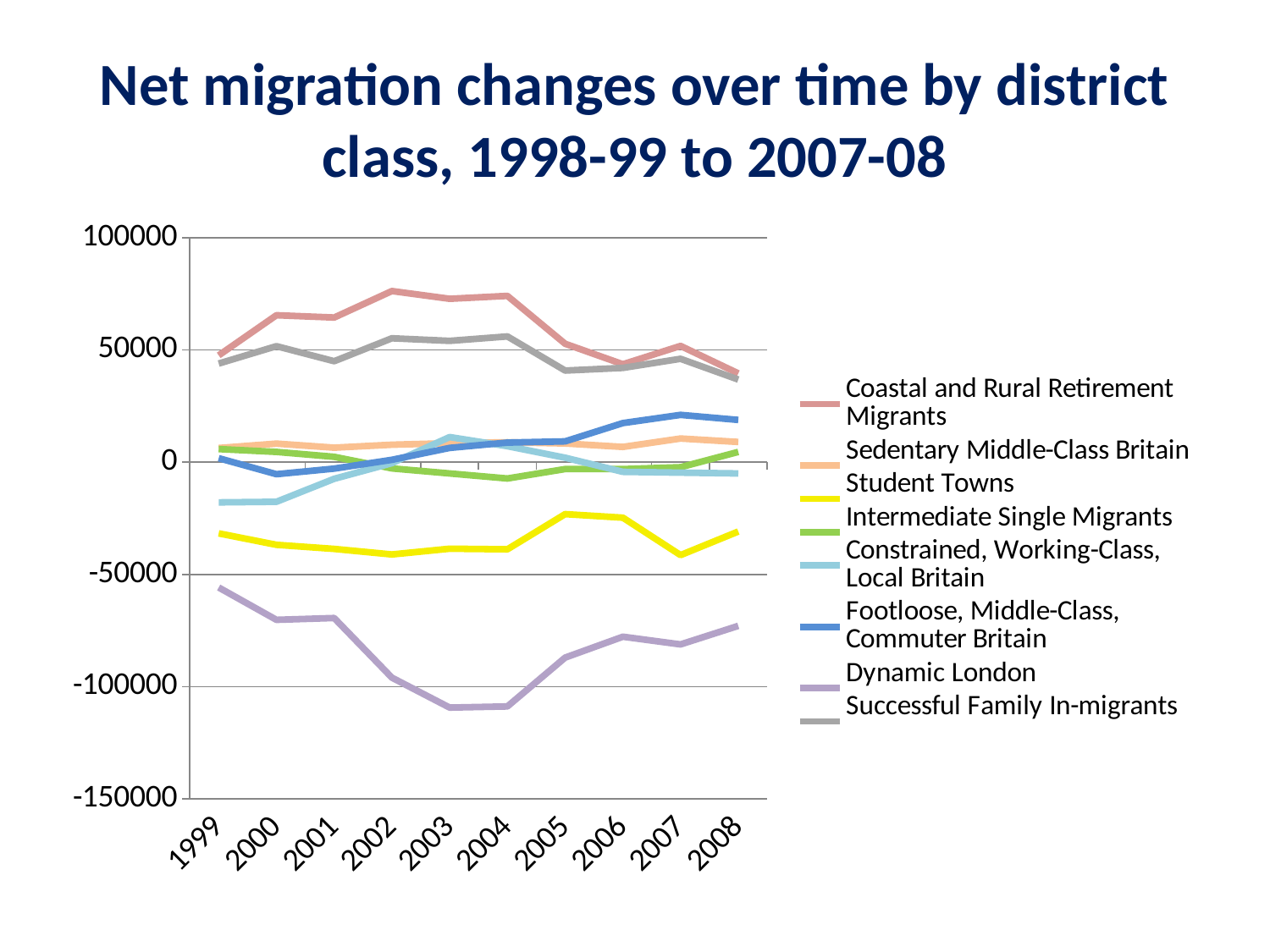
Is the value for Student Towns in 2007 greater or less than -50000? greater In 2005, which is larger: the value for Student Towns or the value for Dynamic London? Student Towns Is the value for Dynamic London in 2003 greater or less than -100000? less How many years are shown along the x axis? 10 Does the Dynamic London line rise or fall from 2003 to 2008? rise Is the value for Coastal and Rural Retirement Migrants in 2002 greater or less than 50000? greater Which series has the highest value in 2002? Coastal and Rural Retirement Migrants Which series has the lowest value in 2003? Dynamic London What kind of chart is shown on the slide? line chart Does the Coastal and Rural Retirement Migrants line rise or fall from 2004 to 2008? fall How many series does the legend list? 8 What is the title of the slide? Net migration changes over time by district class, 1998-99 to 2007-08